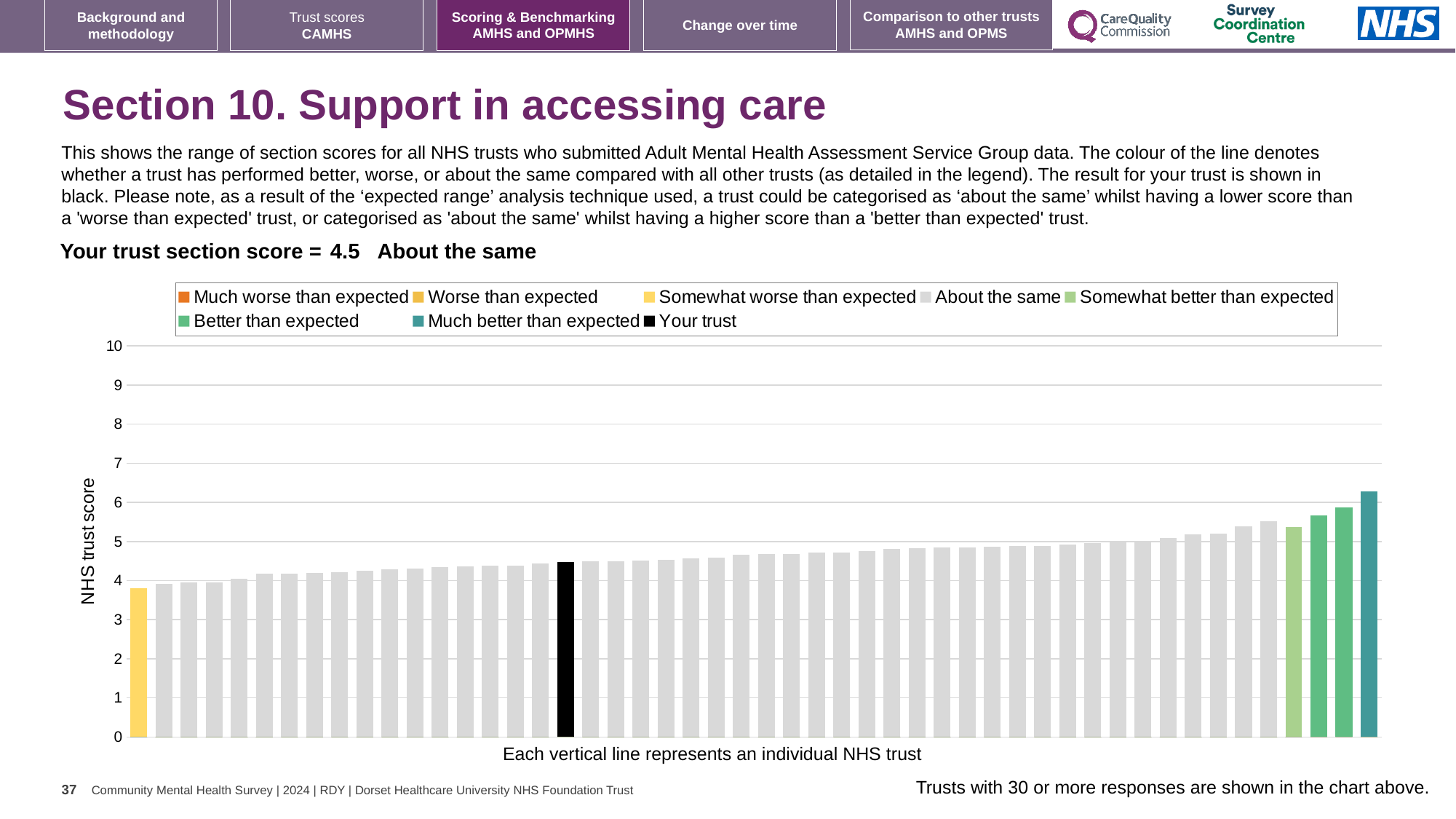
Is the tallest bar in the chart greater or less than 6? greater What is the label on the vertical axis of the chart? NHS trust score Which is larger: the value for your trust (black bar) or the value of the yellow bar at the far left? Your trust Is the shortest bar in the chart greater or less than 4? less Which legend category does the shortest bar in the chart belong to? Somewhat worse than expected What kind of chart is shown on the slide? Bar chart What is the section score for your trust shown on the slide? 4.5 Do the bar values rise or fall from left to right across the chart? Rise Is the value for your trust (the black bar) greater or less than 5? less Which legend category does the tallest bar in the chart belong to? Much better than expected How many entries does the chart legend list? 8